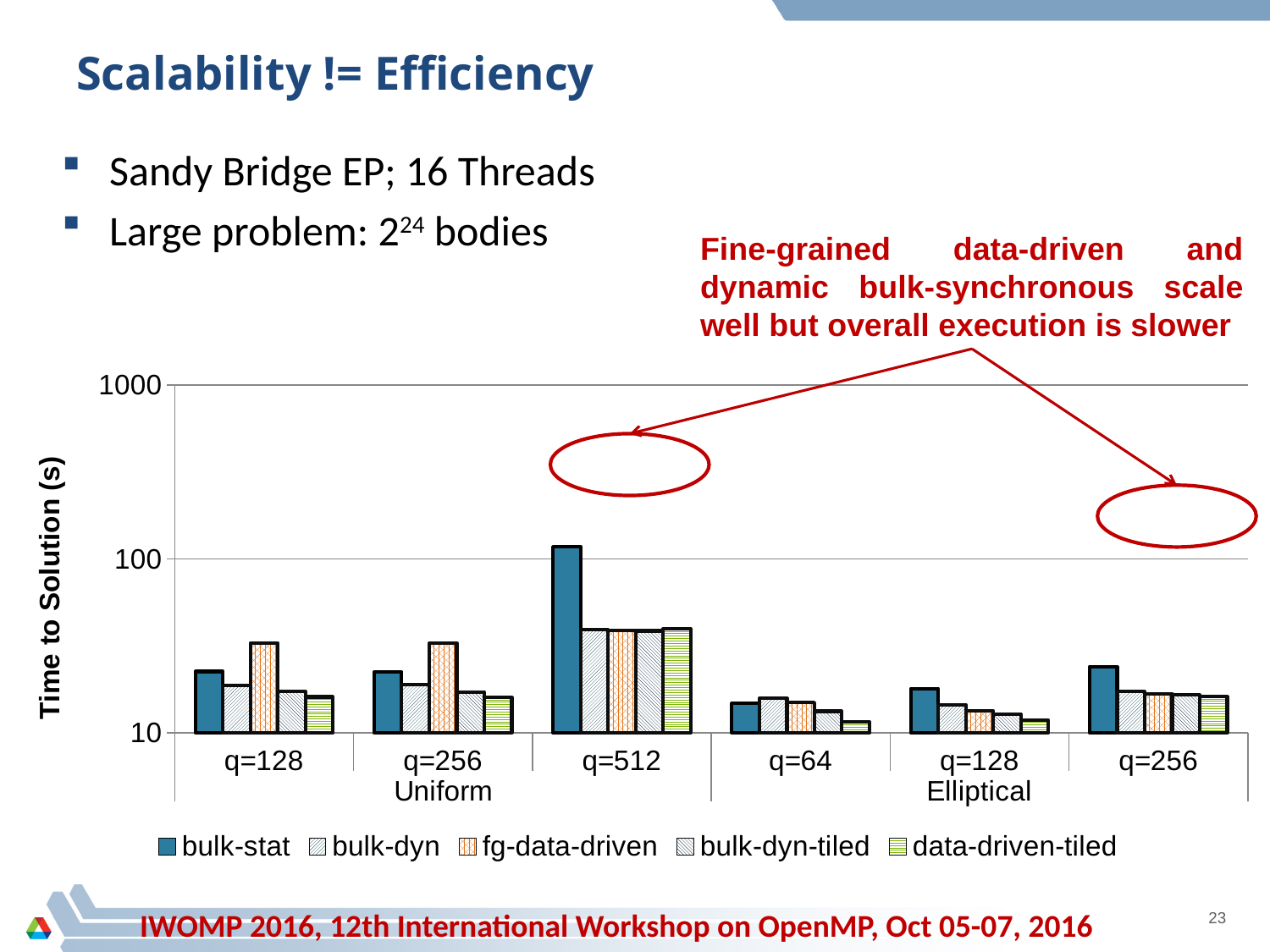
How many series does the legend list? 5 Which is larger: the bulk-stat value for Uniform q=512 or the bulk-stat value for Uniform q=128? Uniform q=512 What kind of chart is shown on the slide? bar chart Which series has the highest value for Uniform q=512? bulk-stat Is the bulk-stat value for Uniform q=512 greater or less than 100? greater Which series is listed first in the legend? bulk-stat How many q-value categories are shown along the x axis? 6 Is the fg-data-driven value for Uniform q=128 greater or less than 100? less What is the label of the y axis? Time to Solution (s) Which series has the highest value for Uniform q=128? fg-data-driven Is the bulk-dyn value for Uniform q=512 greater or less than 100? less Does the bulk-stat value rise or fall from Uniform q=256 to Uniform q=512? rise